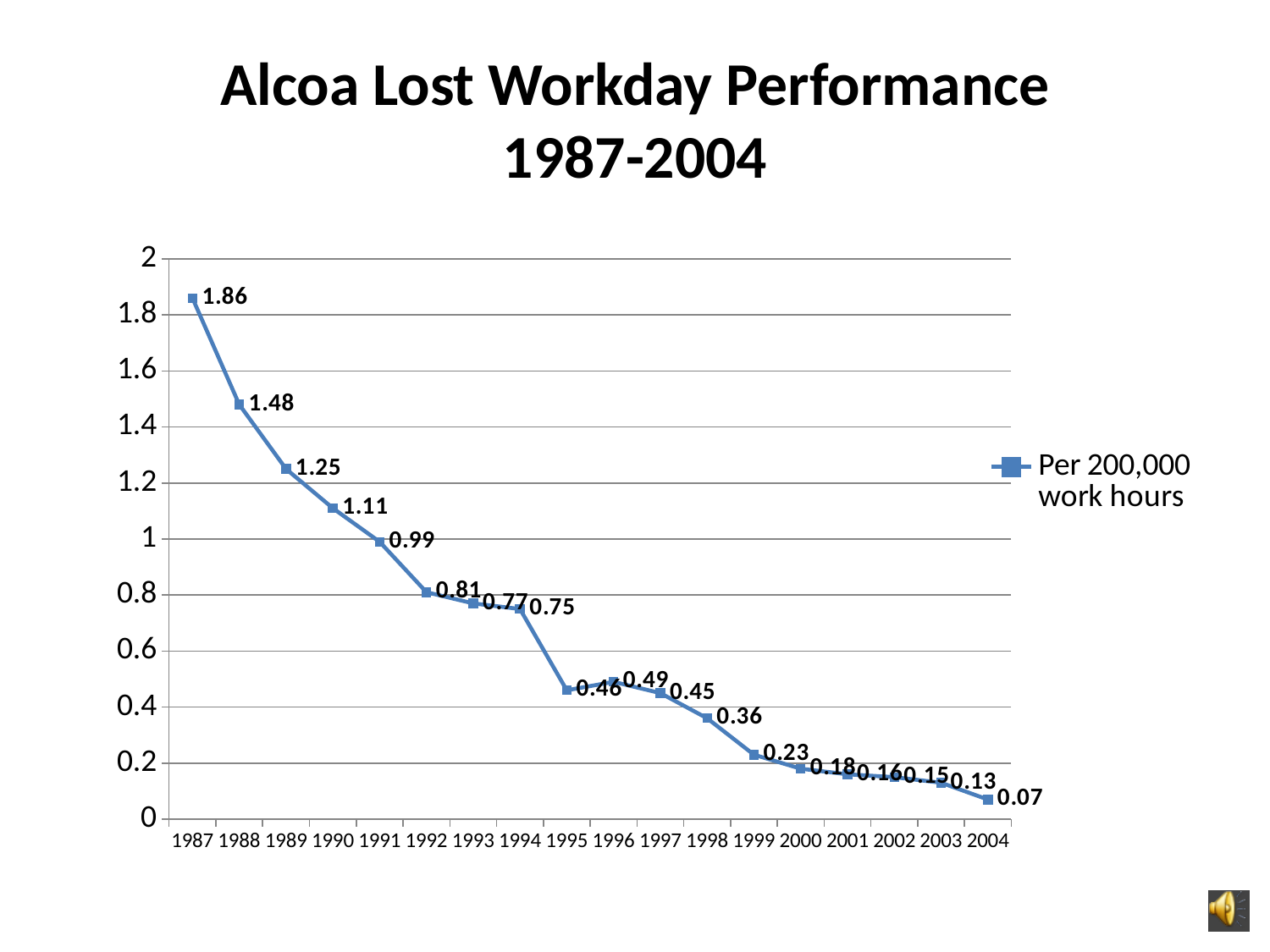
Which year has the highest value? 1987 Is the value for 1991 greater or less than 1? less What kind of chart is shown? line chart Which year has the lowest value? 2004 How many series does the legend list? 1 What is the value for 2004? 0.07 What is the difference between the values for 1987 and 1988? 0.38 What is the value for 1987? 1.86 What is the legend entry for the plotted series? Per 200,000 work hours What is the value for 1994? 0.75 Which is larger, the value for 1995 or the value for 1996? 1996 How many years are plotted on the x axis? 18